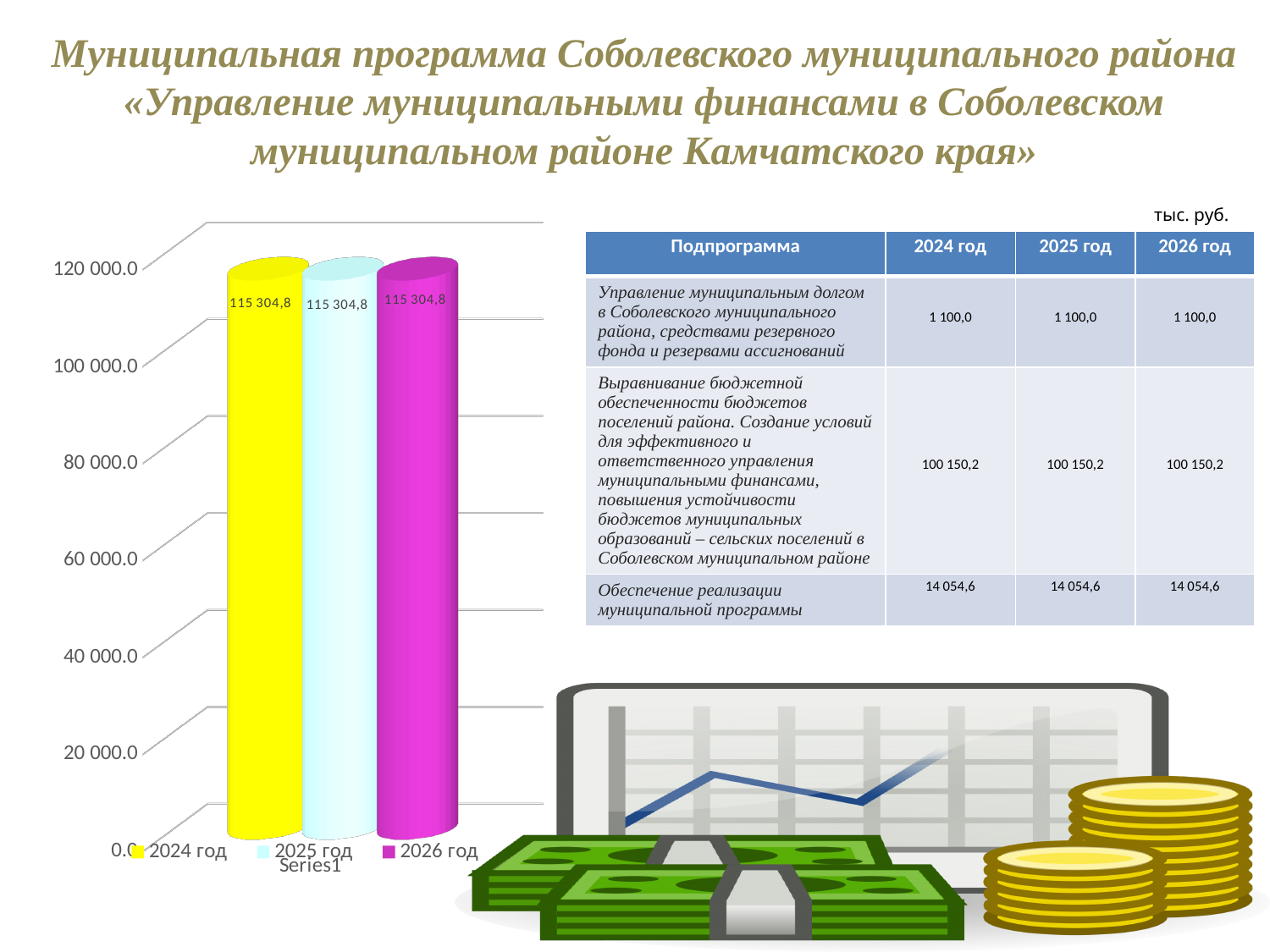
What is the difference between the values for 2025 год and 2024 год? 0,0 Which colour represents 2024 год in the chart legend? yellow What is the value shown for 2026 год in the chart? 115 304,8 What is the value shown for 2025 год in the chart? 115 304,8 How many series does the chart legend list? 3 What is the value shown for 2024 год in the chart? 115 304,8 What kind of chart is shown on the slide? bar chart Do the values change from 2024 год to 2026 год in the chart? No, they stay the same Is the value for 2026 год greater or less than 120 000.0? less Is the value for 2024 год greater or less than 100 000.0? greater Which colour represents 2026 год in the chart legend? magenta How many bars are plotted in the chart? 3